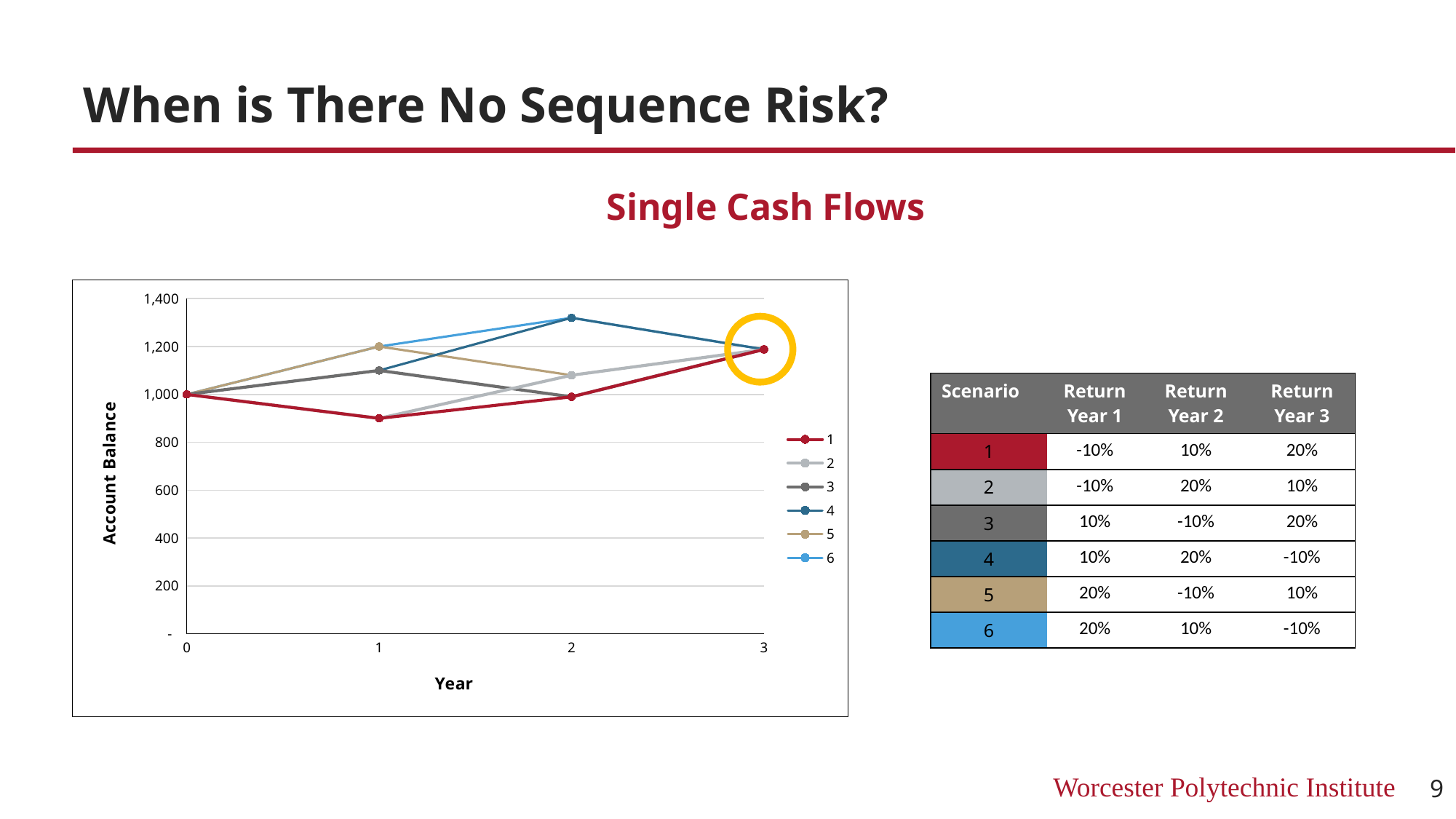
What is the title shown above the chart? Single Cash Flows Is the account balance for series 1 at year 1 greater or less than 1,000? less What is the title of the chart's vertical axis? Account Balance How many series does the chart legend list? 6 What is the account balance for every series at year 0? 1,000 What kind of chart is shown on the slide? line chart At year 2, which has the larger account balance, series 4 or series 1? series 4 Does the account balance for series 1 rise or fall from year 0 to year 1? fall Is the account balance for series 2 at year 2 greater or less than 1,000? greater What is the account balance for series 5 at year 1? 1,200 How many points (years) are plotted along the x axis for each series? 4 Is the account balance for series 4 at year 2 greater or less than 1,200? greater